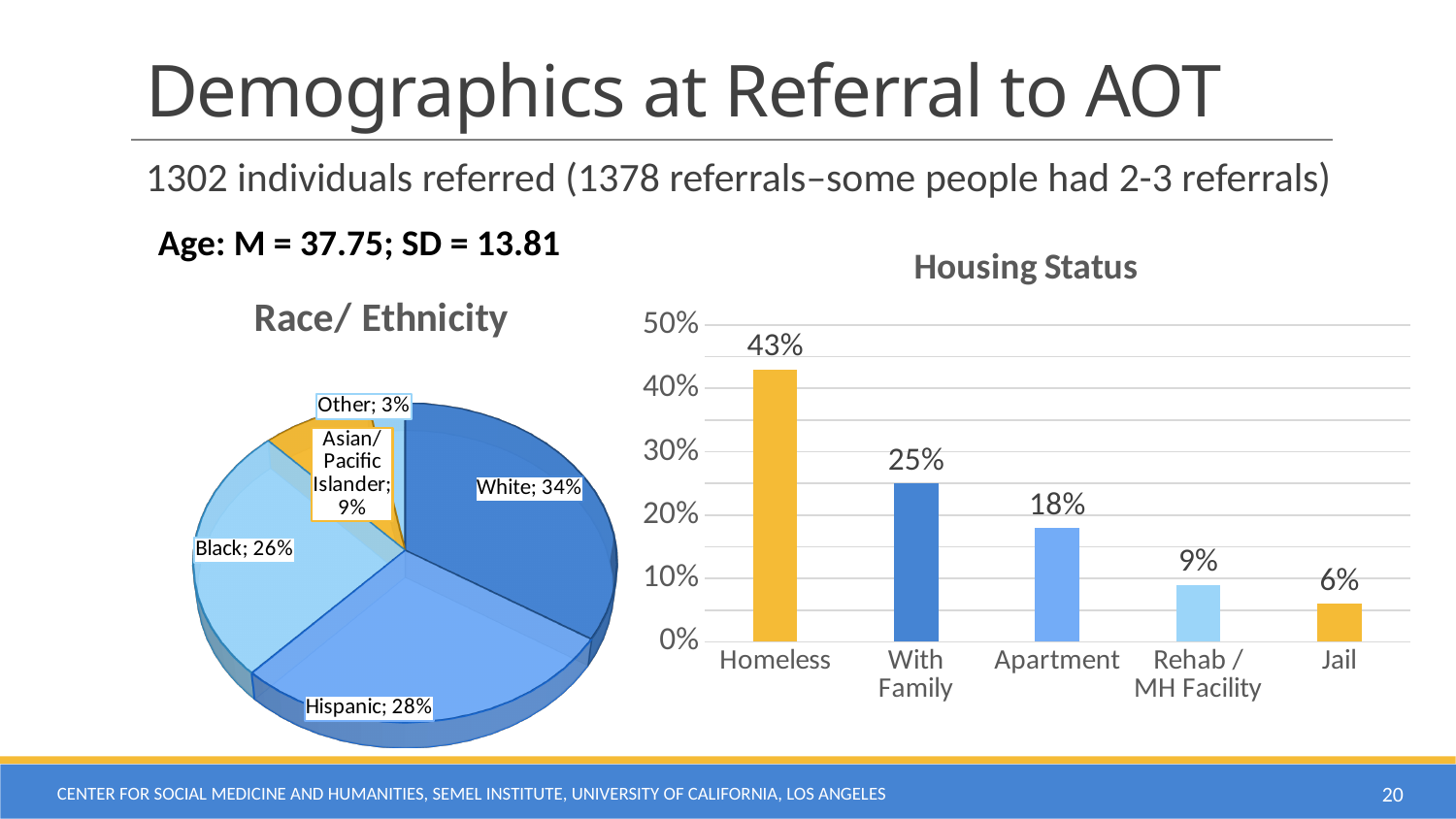
In the Housing Status chart, which is larger, Apartment or Jail? Apartment In the Race/ Ethnicity chart, what is the difference between the Hispanic and Black shares? 2% In the Housing Status chart, which category has the lowest value? Jail In the Race/ Ethnicity chart, what share is labelled for White? 34% In the Race/ Ethnicity chart, which category has the largest slice? White In the Housing Status chart, what is the value for Homeless? 43% In the Race/ Ethnicity chart, which category has the smallest slice? Other In the Race/ Ethnicity chart, how many slices does the pie have? 5 In the Race/ Ethnicity chart, what share is labelled for Asian/Pacific Islander? 9% In the Housing Status chart, what is the difference between Homeless and With Family? 18% What kind of chart is the Housing Status chart? Bar chart In the Housing Status chart, what is the value for Rehab / MH Facility? 9%